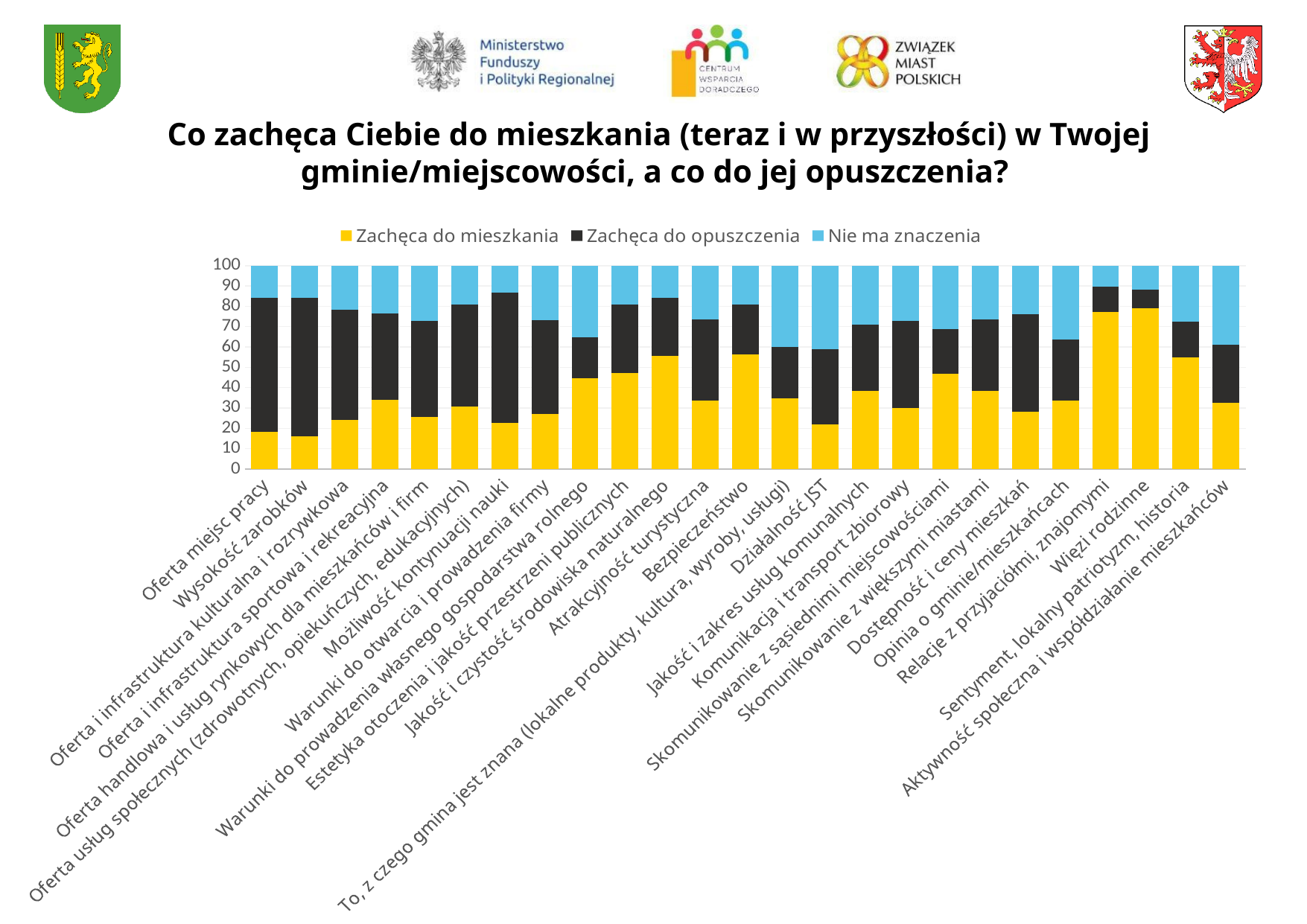
Which series is shown in yellow? Zachęca do mieszkania Is the 'Nie ma znaczenia' value for 'Więzi rodzinne' greater or less than 20? less What kind of chart is shown on the slide? stacked bar chart How many series does the legend list? 3 Is the 'Zachęca do mieszkania' value for 'Oferta miejsc pracy' greater or less than 20? less Which has the larger 'Zachęca do mieszkania' share: 'Relacje z przyjaciółmi, znajomymi' or 'Działalność JST'? Relacje z przyjaciółmi, znajomymi Which has the larger 'Zachęca do opuszczenia' share: 'Wysokość zarobków' or 'Więzi rodzinne'? Wysokość zarobków Which series is shown in light blue? Nie ma znaczenia Is the 'Zachęca do mieszkania' value for 'Jakość i czystość środowiska naturalnego' greater or less than 50? greater How many categories are plotted along the x axis? 25 What is the total height of each stacked bar on the axis? 100